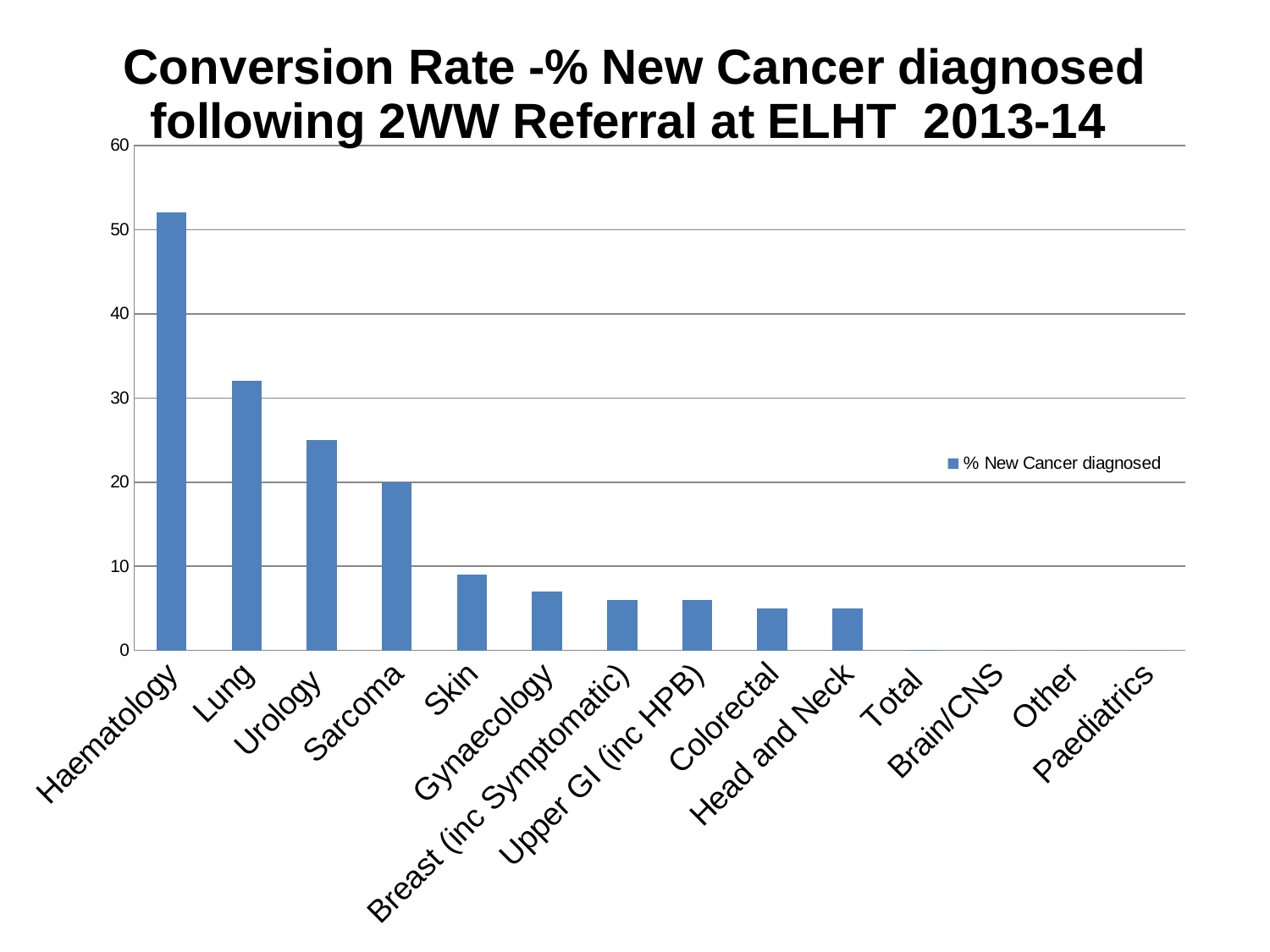
Which is larger, the value for Sarcoma or the value for Skin? Sarcoma What is the series name shown in the legend? % New Cancer diagnosed How many series does the legend list? 1 Is the value for Urology greater or less than 30? less What kind of chart is shown on the slide? bar chart Is the value for Lung greater or less than 30? greater Which is larger, the value for Lung or the value for Urology? Lung How many categories are shown on the x axis? 14 Is the value for Haematology greater or less than 50? greater Which category has the highest % New Cancer diagnosed? Haematology Do the values generally rise or fall moving from left to right along the x axis? fall